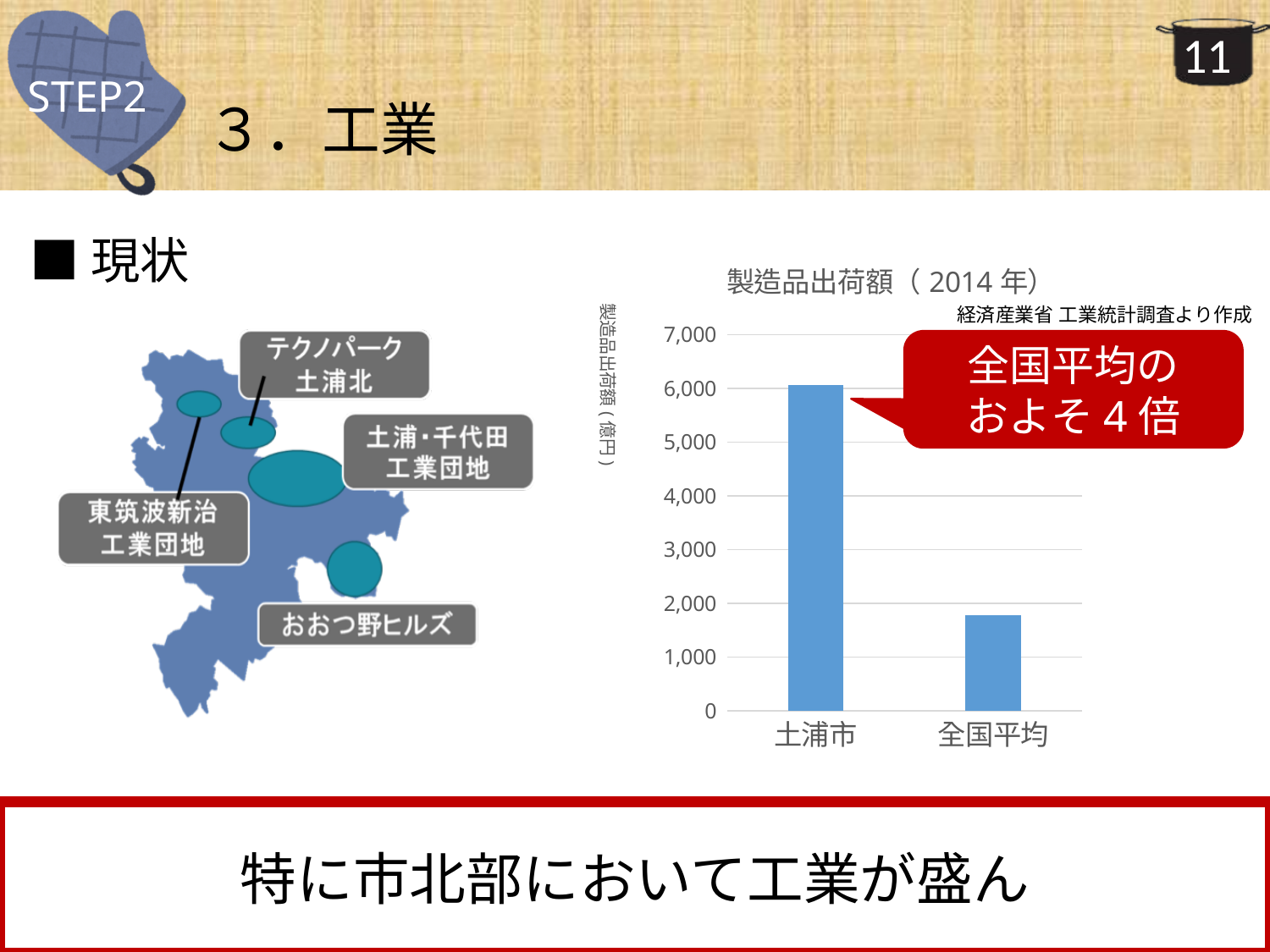
Is the value for 全国平均 greater or less than 1,000? greater What kind of chart is shown on the slide? bar chart How many categories are plotted in the chart? 2 Which category has the lowest value in the chart? 全国平均 Is the value for 土浦市 greater or less than 7,000? less Which is larger, the value for 土浦市 or the value for 全国平均? 土浦市 Is the value for 全国平均 greater or less than 2,000? less Which category has the highest value in the chart? 土浦市 What is the title of the chart? 製造品出荷額（2014年） What is the label on the vertical axis of the chart? 製造品出荷額（億円）